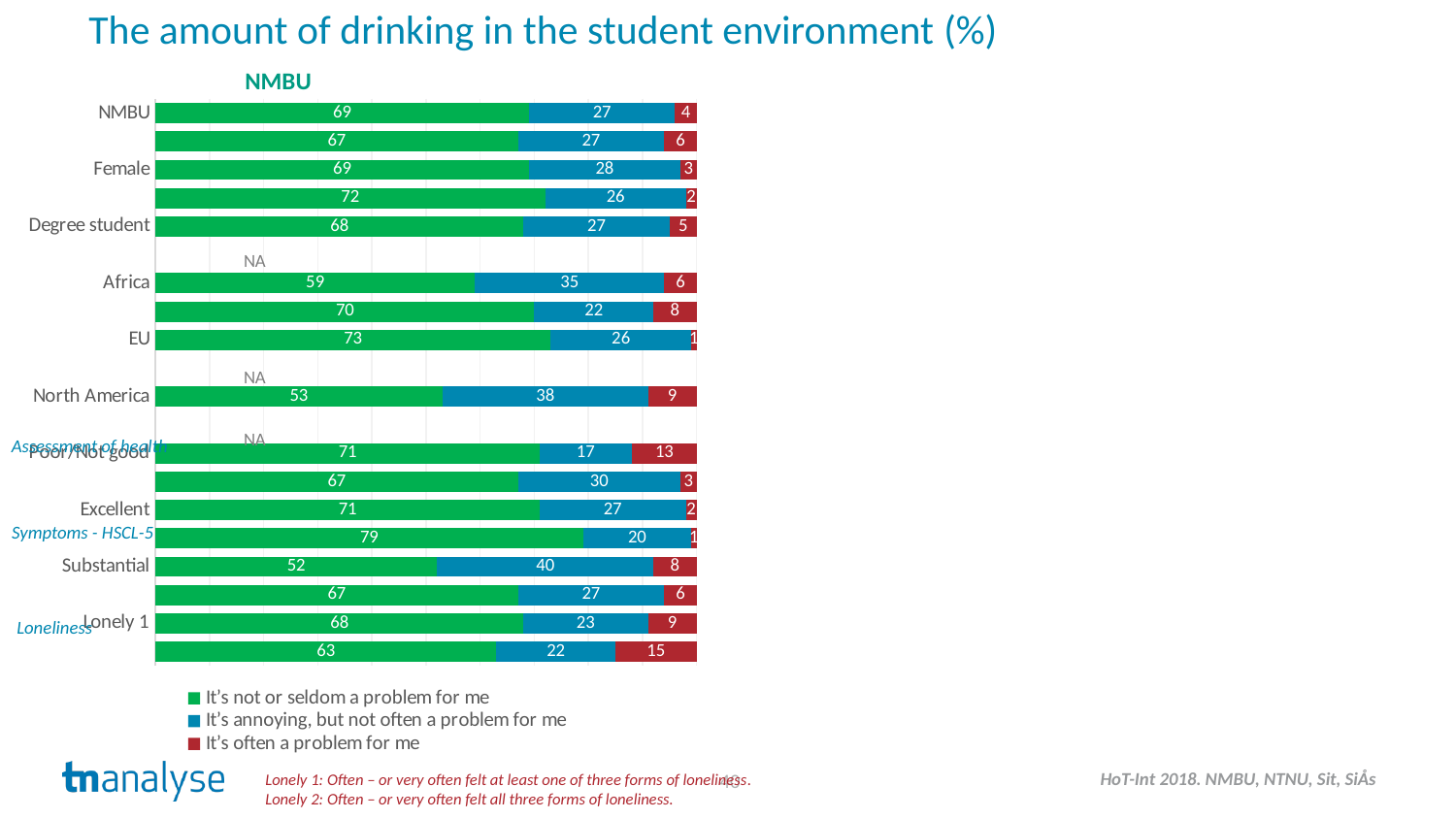
Which is larger: the "It's not or seldom a problem for me" value for EU or for North America? EU What is the total of the stacked bar for Lonely 1? 100 What is the value of "It's often a problem for me" for Poor/Not good? 13 What is the value of "It's not or seldom a problem for me" for NMBU? 69 What is the value of "It's not or seldom a problem for me" for Substantial? 52 Which colour represents "It's often a problem for me" in the legend? Red What kind of chart is shown on the slide? Stacked bar chart What is the value of "It's often a problem for me" for North America? 9 What is the difference between the "It's often a problem for me" values for Lonely 1 and Excellent? 7 What is the difference between the "It's annoying, but not often a problem for me" values for Substantial and Poor/Not good? 23 How many series does the legend list? 3 What is the value of "It's annoying, but not often a problem for me" for Africa? 35